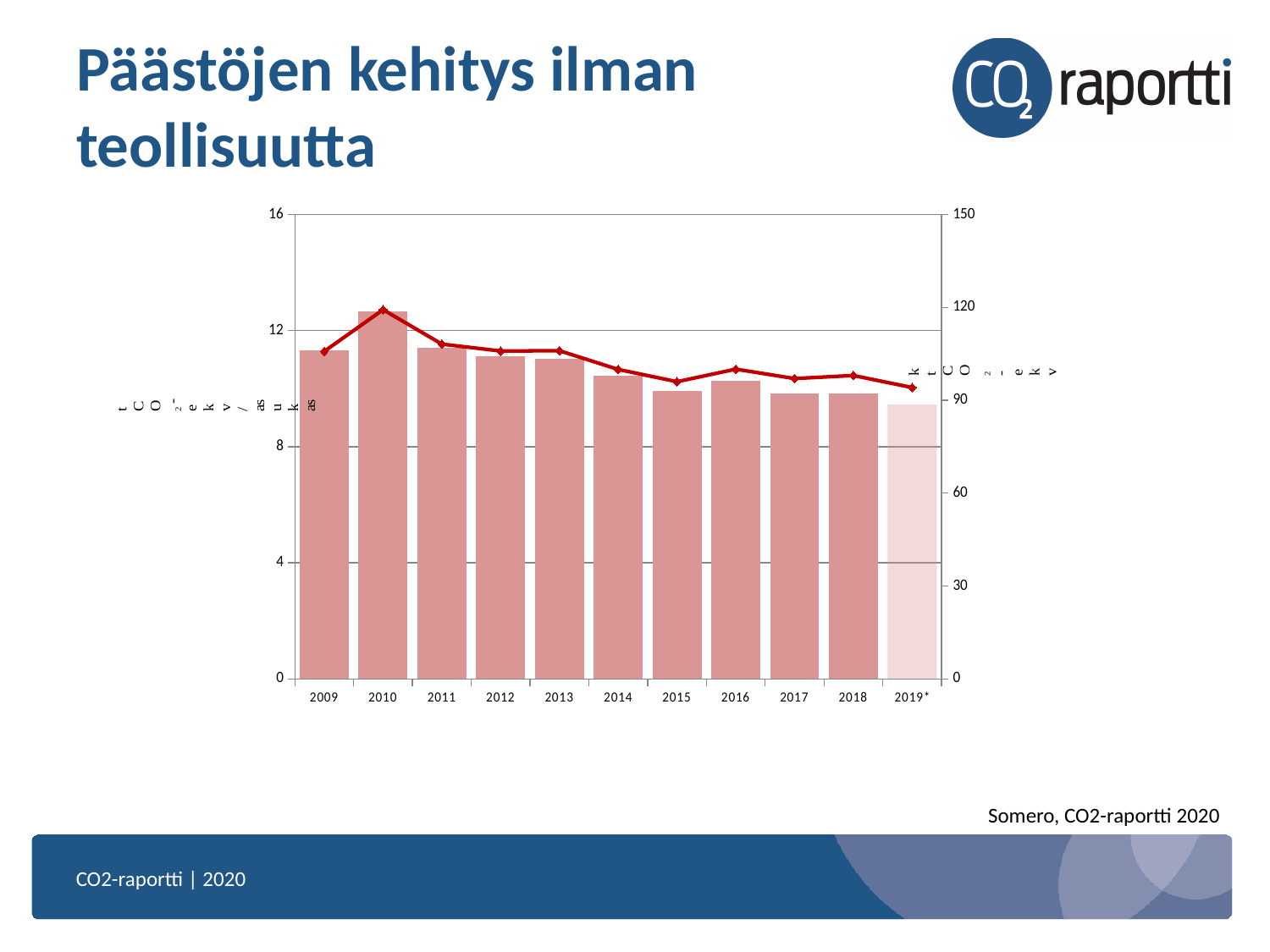
How many years are shown on the x axis of the chart? 11 Is the bar for 2009 greater or less than 8 on the left axis? greater Which year has the tallest bar in the chart? 2010 What kind of chart is shown on the slide? A bar chart with a line Do the bars generally rise or fall from 2010 to 2019*? fall Which bar is taller, 2010 or 2015? 2010 Which bar is taller, 2009 or 2014? 2009 In which year does the line reach its highest point? 2010 Is the bar for 2010 greater or less than 12 on the left axis? greater What is the title of the slide containing the chart? Päästöjen kehitys ilman teollisuutta Is the bar for 2019* greater or less than 12 on the left axis? less